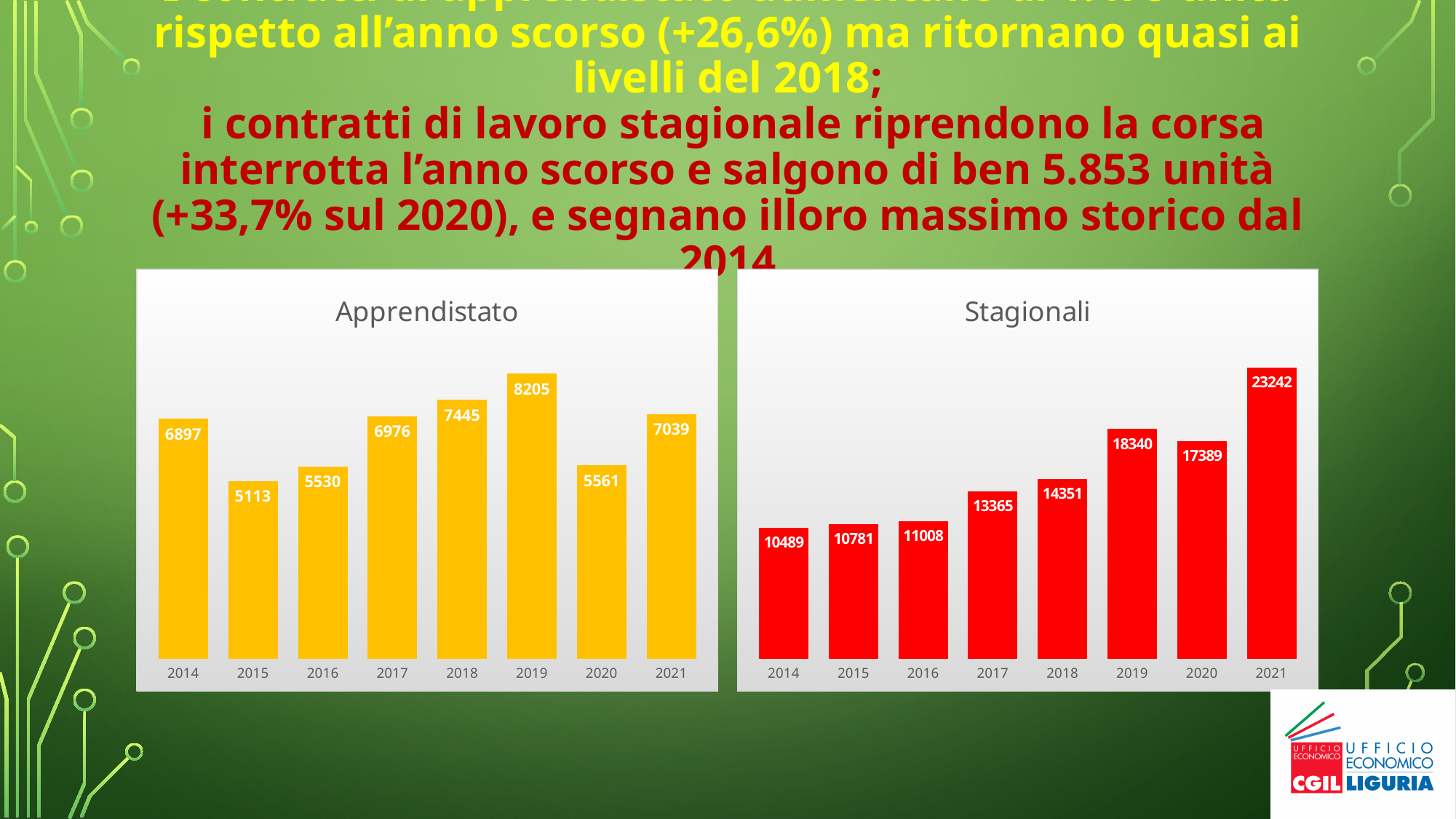
In the Stagionali chart, what is the difference between the 2021 value and the 2020 value? 5853 In the Stagionali chart, which is larger, the value for 2019 or the value for 2020? 2019 In the Stagionali chart, which year has the highest value? 2021 In the Stagionali chart, what is the value for 2021? 23242 In the Apprendistato chart, what is the value for 2014? 6897 In the Apprendistato chart, what is the value for 2019? 8205 In the Apprendistato chart, what is the difference between the 2021 value and the 2020 value? 1478 In the Stagionali chart, do the values rise or fall from 2014 to 2019? rise What kind of chart is the Stagionali chart? bar chart In the Apprendistato chart, how many years are shown on the x axis? 8 In the Apprendistato chart, which year has the lowest value? 2015 What colour are the bars in the Stagionali chart? red